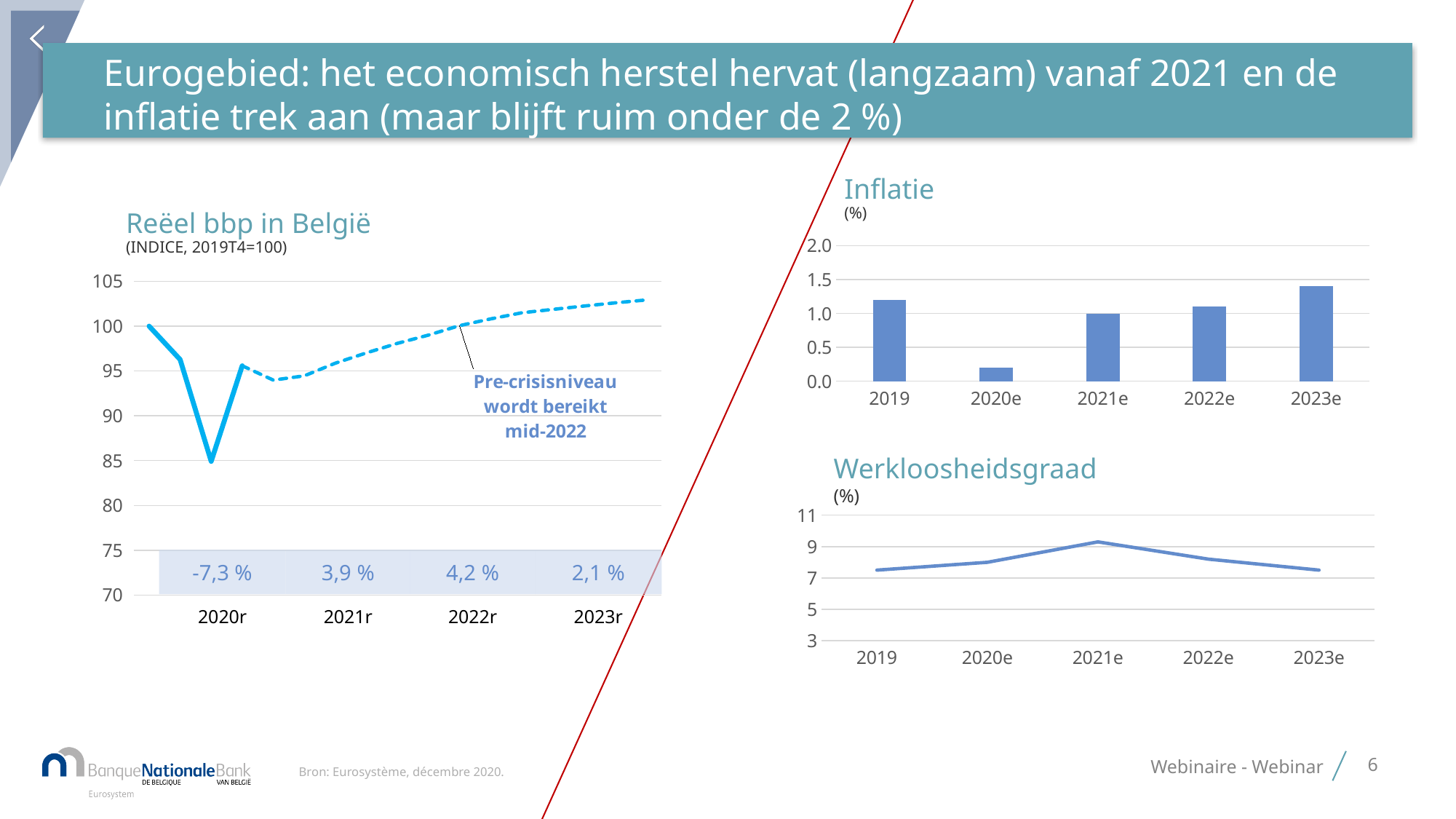
In the 'Reëel bbp in België' chart, what is the difference between the growth figures for 2022r and 2023r? 2,1 percentage points In the 'Werkloosheidsgraad' chart, which year has the highest value? 2021e In the 'Inflatie' chart, which year has the highest bar? 2023e In the 'Inflatie' chart, is the value for 2020e greater or less than 0.5? less In the 'Reëel bbp in België' chart, which year has the highest growth figure shown? 2022r In the 'Reëel bbp in België' chart, when does the annotation say the pre-crisis level is reached? mid-2022 What kind of chart is the 'Inflatie' chart? bar chart In the 'Reëel bbp in België' chart, which year has the lowest growth figure shown? 2020r How many years are shown on the x axis of the 'Inflatie' chart? 5 In the 'Inflatie' chart, which year has the lowest bar? 2020e What kind of chart is the 'Werkloosheidsgraad' chart? line chart In the 'Reëel bbp in België' chart, what growth figure is shown for 2021r? 3,9 %